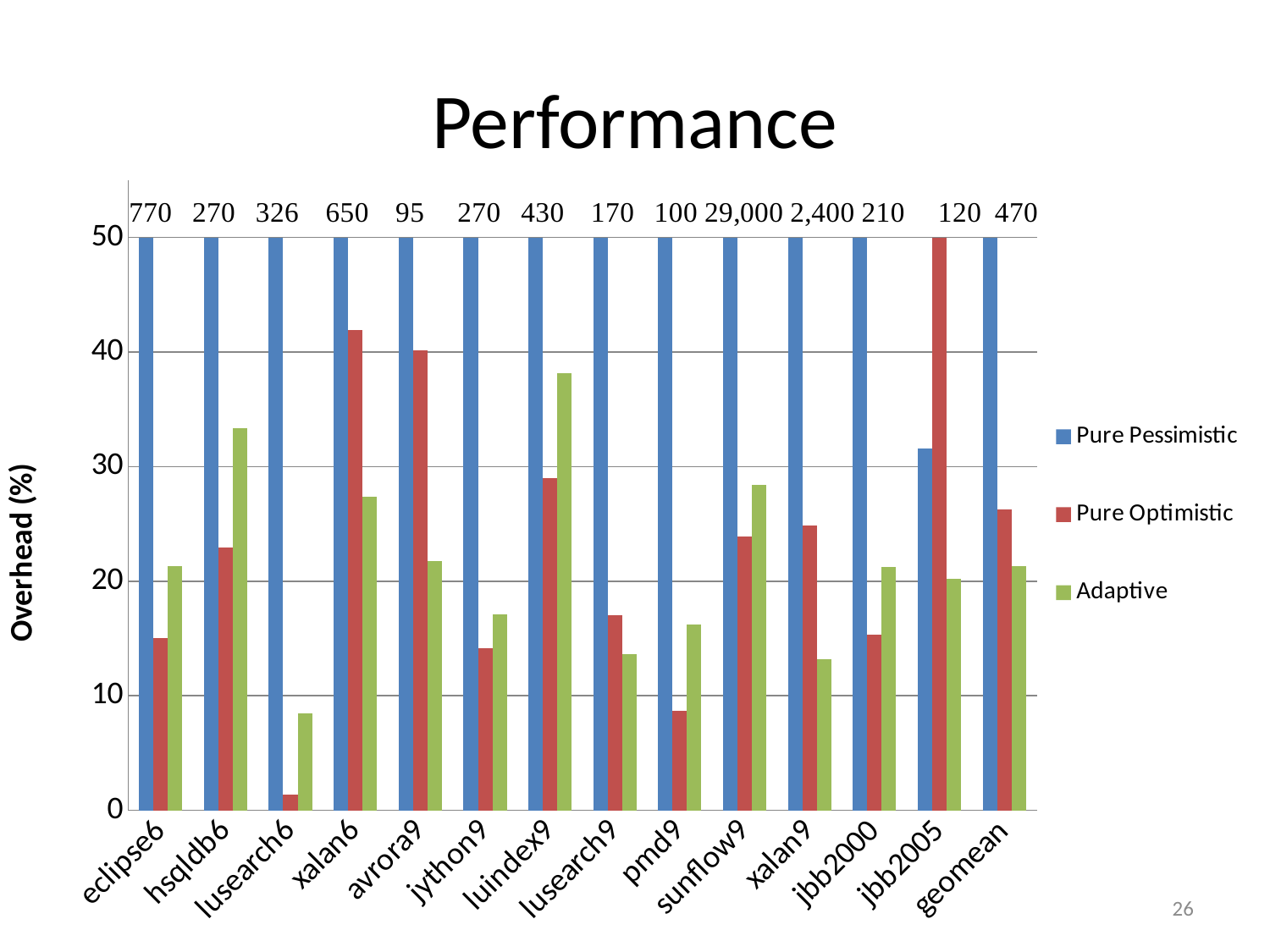
Is the Adaptive value for hsqldb6 greater or less than 30? greater What value is printed above the Pure Pessimistic bar for xalan9? 2,400 What type of chart is shown on the slide? bar chart For avrora9, which is larger: Pure Optimistic or Adaptive? Pure Optimistic What value is printed above the Pure Pessimistic bar for eclipse6? 770 Which category has the highest Adaptive overhead? luindex9 What is the label of the y axis? Overhead (%) How many benchmark categories are shown on the x axis? 14 Which category has the lowest Pure Optimistic overhead? lusearch6 How many series does the legend list? 3 Is the Pure Optimistic value for pmd9 greater or less than 10? less What value is printed above the Pure Pessimistic bar for sunflow9? 29,000